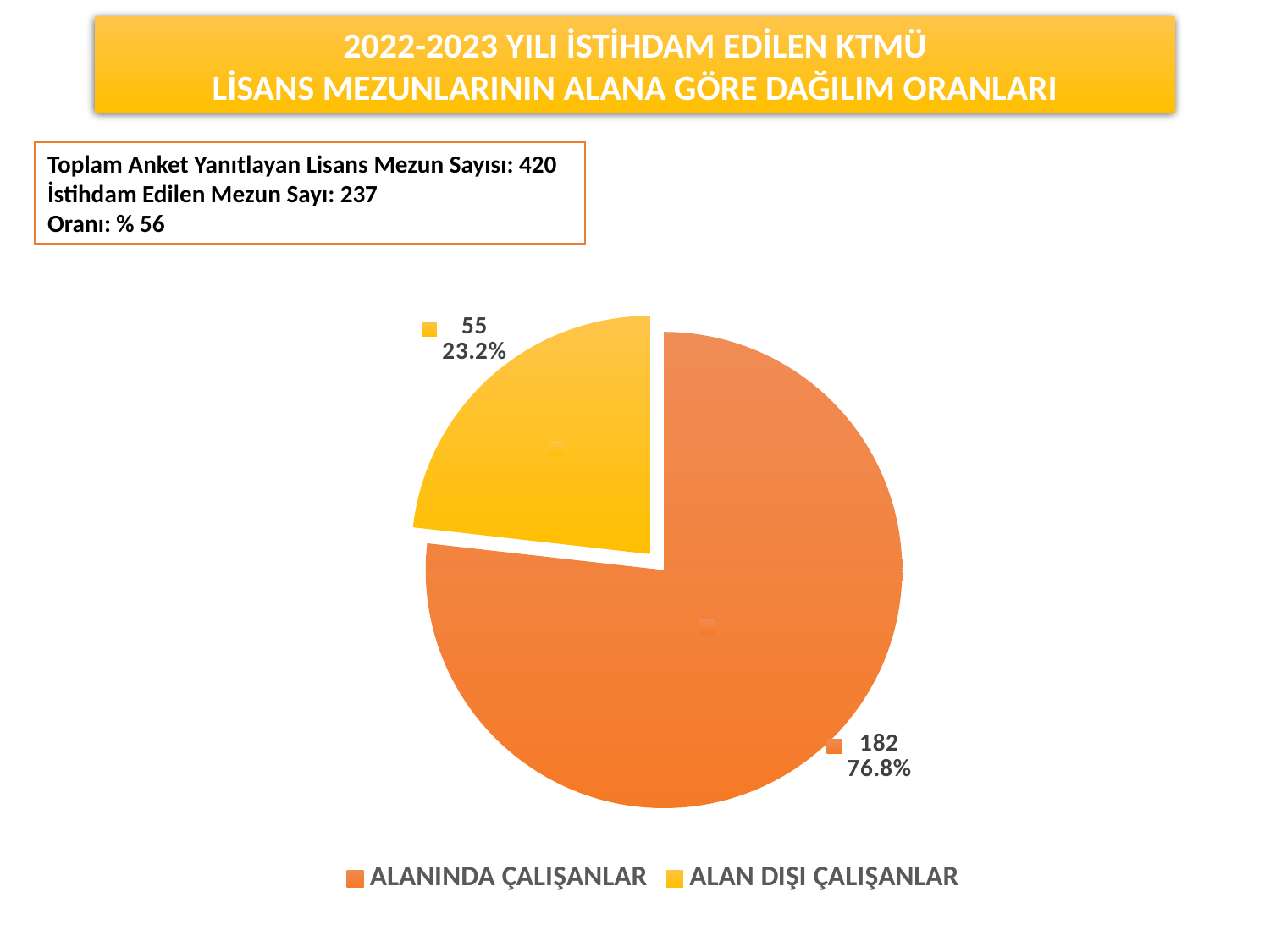
What is the difference between the values for ALANINDA ÇALIŞANLAR and ALAN DIŞI ÇALIŞANLAR? 127 What type of chart is shown on the slide? pie chart Which category has the smallest slice? ALAN DIŞI ÇALIŞANLAR What is the total of the two slice values? 237 What percentage share does ALANINDA ÇALIŞANLAR have in the pie? 76.8% What colour is the slice for ALAN DIŞI ÇALIŞANLAR? yellow Which is larger, ALANINDA ÇALIŞANLAR or ALAN DIŞI ÇALIŞANLAR? ALANINDA ÇALIŞANLAR How many slices does the pie chart have? 2 What percentage share does ALAN DIŞI ÇALIŞANLAR have in the pie? 23.2% What is the value for ALAN DIŞI ÇALIŞANLAR? 55 What is the value for ALANINDA ÇALIŞANLAR? 182 Which category has the largest slice? ALANINDA ÇALIŞANLAR